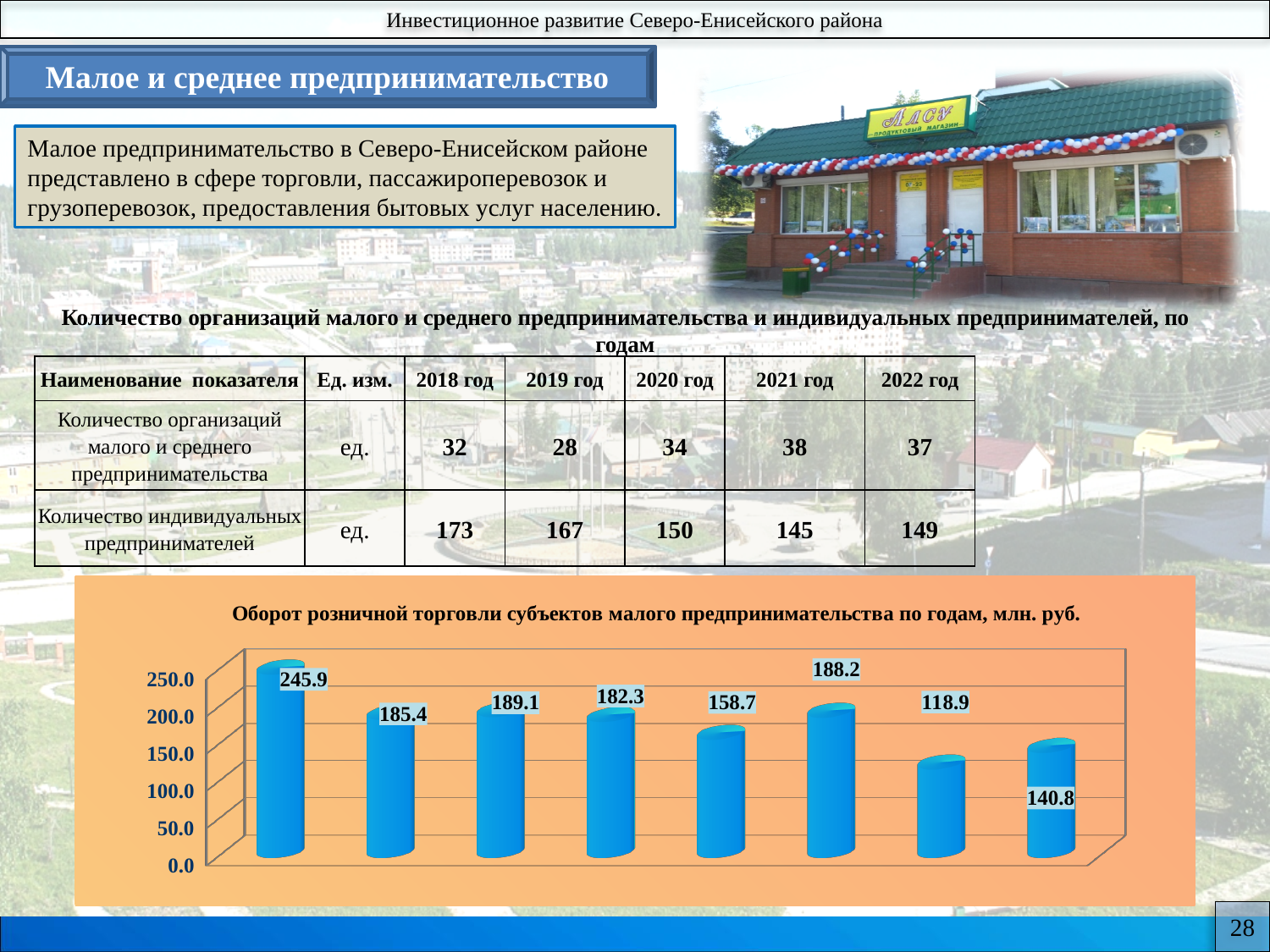
In the retail turnover chart, do the values generally rise or fall from the first bar to the last bar? fall What is the lowest value shown in the retail turnover chart? 118.9 What kind of chart is shown at the bottom of the slide? bar chart What is the value of the sixth bar from the left in the retail turnover chart? 188.2 What is the highest tick value shown on the vertical axis of the retail turnover chart? 250.0 What is the value of the last (rightmost) bar in the retail turnover chart? 140.8 What is the value of the first (leftmost) bar in the retail turnover chart? 245.9 What is the highest value shown in the retail turnover chart? 245.9 In the retail turnover chart, what is the difference between the first bar (245.9) and the second bar (185.4)? 60.5 In the retail turnover chart, is the value of the seventh bar greater or less than 150.0? less How many bars are plotted in the chart titled "Оборот розничной торговли субъектов малого предпринимательства по годам, млн. руб."? 8 In the retail turnover chart, which is larger: the third bar (189.1) or the fourth bar (182.3)? the third bar (189.1)